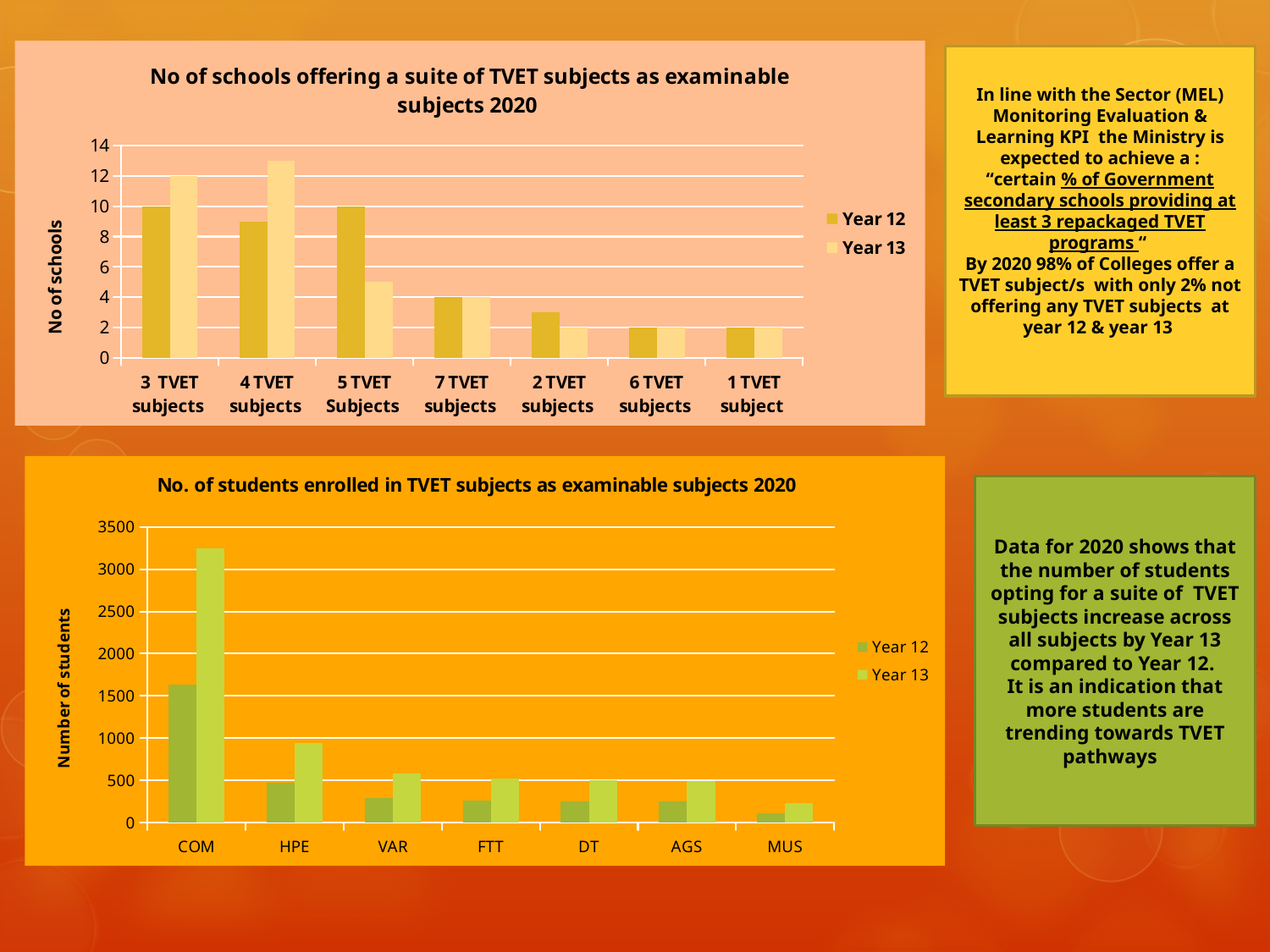
In the bottom chart, 'No. of students enrolled in TVET subjects as examinable subjects 2020', is the Year 13 value for COM greater or less than 3000? greater In the top chart, 'No of schools offering a suite of TVET subjects as examinable subjects 2020', what is the Year 13 value for '3 TVET subjects'? 12 In the top chart, 'No of schools offering a suite of TVET subjects as examinable subjects 2020', what kind of chart is shown? Bar chart In the top chart, 'No of schools offering a suite of TVET subjects as examinable subjects 2020', what is the Year 12 value for '7 TVET subjects'? 4 In the bottom chart, 'No. of students enrolled in TVET subjects as examinable subjects 2020', which category has the lowest Year 12 value? MUS In the top chart, 'No of schools offering a suite of TVET subjects as examinable subjects 2020', which category has the highest Year 13 value? 4 TVET subjects In the top chart, 'No of schools offering a suite of TVET subjects as examinable subjects 2020', how many categories are shown on the x axis? 7 In the top chart, 'No of schools offering a suite of TVET subjects as examinable subjects 2020', how many series does the legend list? 2 In the top chart, 'No of schools offering a suite of TVET subjects as examinable subjects 2020', is the Year 12 value for '5 TVET Subjects' larger or smaller than the Year 13 value? Larger In the top chart, 'No of schools offering a suite of TVET subjects as examinable subjects 2020', is the Year 13 value for '5 TVET Subjects' greater or less than 6? less In the bottom chart, 'No. of students enrolled in TVET subjects as examinable subjects 2020', which category has the highest Year 13 value? COM